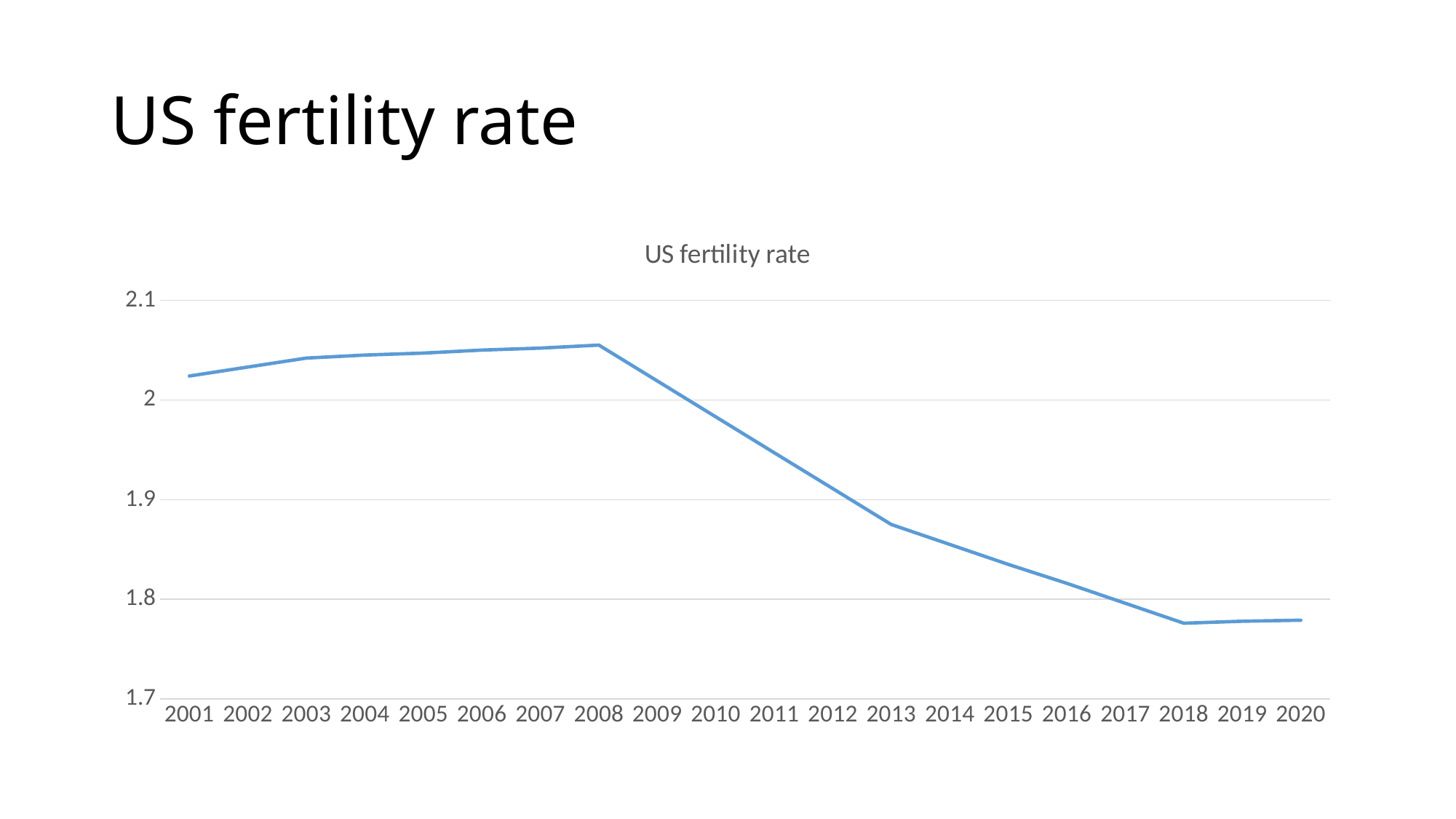
Is the value for 2018 greater or less than 1.8? less Is the value for 2001 greater or less than 2? greater Is the value for 2013 greater or less than 1.9? less Does the US fertility rate rise or fall between 2008 and 2018? fall What is the title of the chart? US fertility rate Which year has the highest US fertility rate? 2008 How many years are plotted along the x axis? 20 Which is larger, the value for 2008 or the value for 2013? 2008 Which is larger, the value for 2003 or the value for 2016? 2003 What kind of chart is shown on the slide? line chart